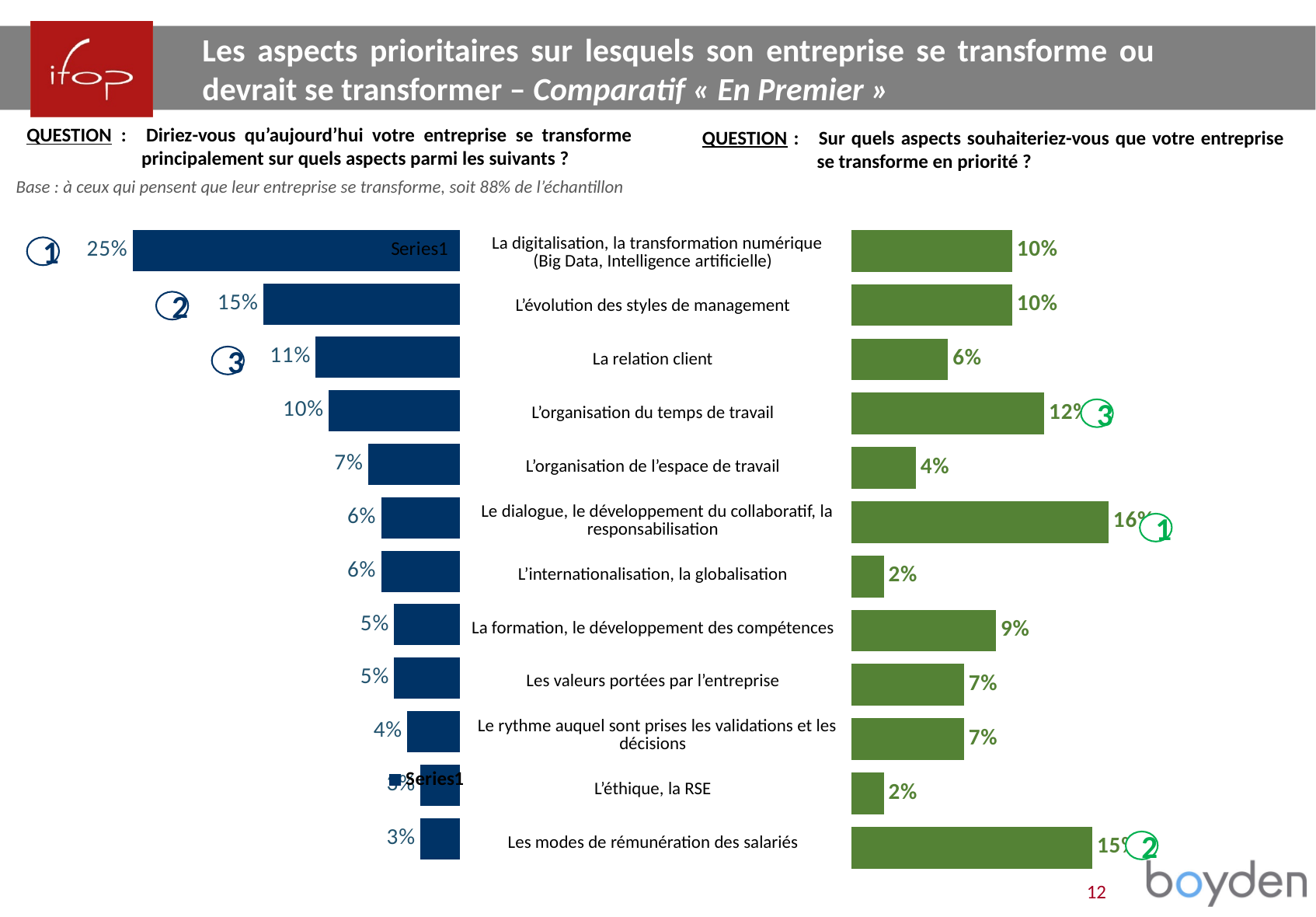
On the left (blue) chart, what is the value for 'L'organisation du temps de travail'? 10% How many categories are shown on the right (green) chart? 12 On the right (green) chart, what is the difference between 'La formation, le développement des compétences' and 'Les valeurs portées par l'entreprise'? 2% Which is larger: the value for 'Les modes de rémunération des salariés' on the left (blue) chart or on the right (green) chart? Right (green) chart What type of chart is the left (blue) chart? Bar chart On the left (blue) chart, what is the value for 'La digitalisation, la transformation numérique'? 25% Which is larger: the value for 'La relation client' on the left (blue) chart or on the right (green) chart? Left (blue) chart On the right (green) chart, what is the value for 'La formation, le développement des compétences'? 9% On the left (blue) chart, what is the difference between 'La digitalisation, la transformation numérique' and 'L'évolution des styles de management'? 10% On the right (green) chart, which category has the highest value? Le dialogue, le développement du collaboratif, la responsabilisation On the left (blue) chart, which category has the highest value? La digitalisation, la transformation numérique (Big Data, Intelligence artificielle) On the right (green) chart, what is the value for 'L'internationalisation, la globalisation'? 2%